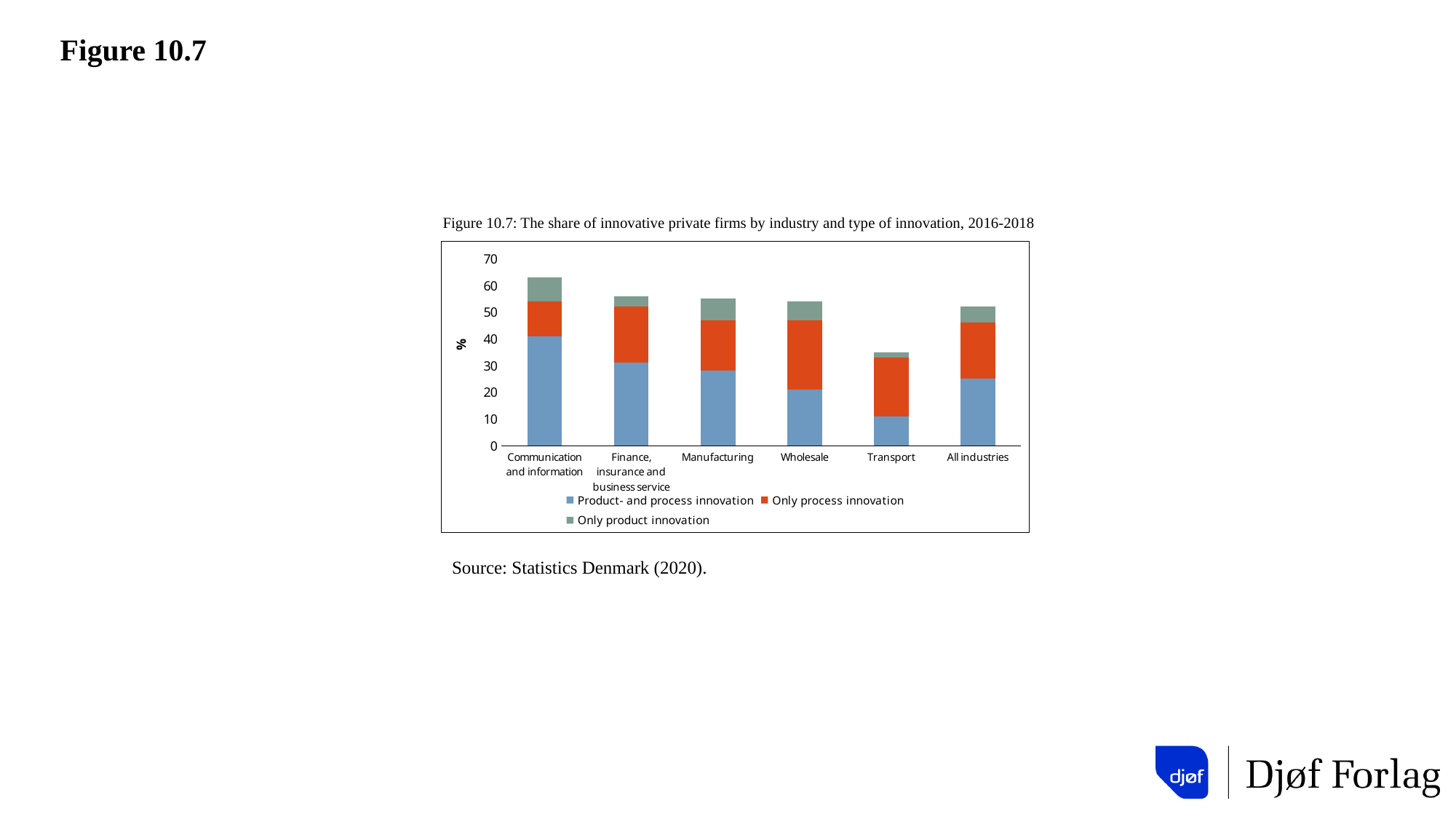
Which industry has the largest 'Product- and process innovation' segment? Communication and information Which industry has the smallest 'Product- and process innovation' segment? Transport What kind of chart is shown on the slide? Stacked bar chart Is the total stacked value for Communication and information greater or less than 60? greater Is the 'Product- and process innovation' value for Transport greater or less than 20? less What is the label on the vertical axis? % Which industry has the tallest stacked bar overall? Communication and information How many industry categories are shown on the x axis? 6 Which has the larger total stacked bar, Communication and information or Finance, insurance and business service? Communication and information Is the total stacked value for Transport greater or less than 40? less How many series does the legend list? 3 Which industry has the shortest stacked bar overall? Transport